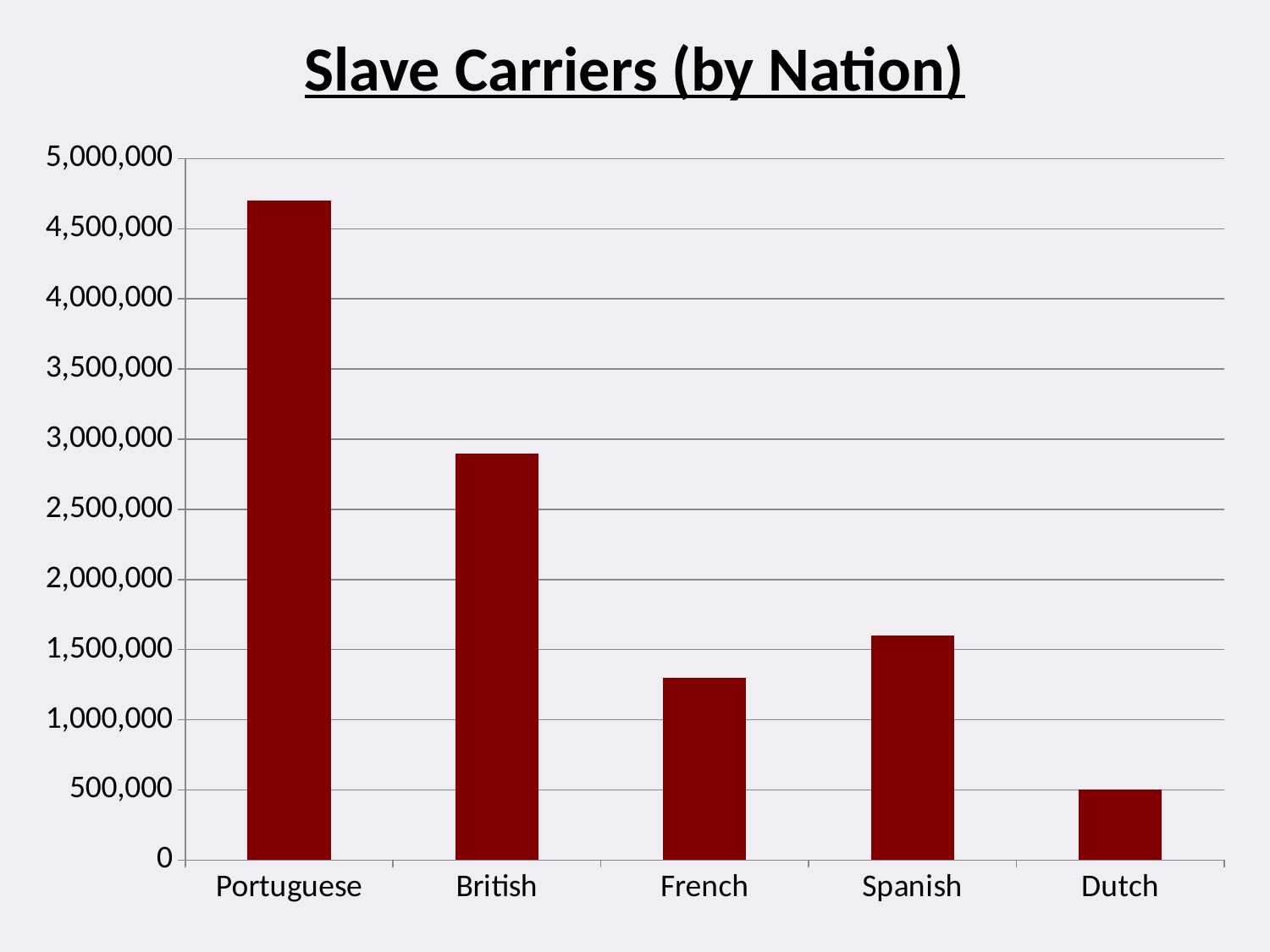
Which nation has the lowest bar in the chart? Dutch Is the value for British greater or less than 3,000,000? less Is the value for Spanish greater or less than 2,000,000? less Which nation has the highest bar in the chart? Portuguese How many nations are shown on the x axis of the chart? 5 Is the value for Portuguese greater or less than 4,500,000? greater What type of chart is shown on the slide? bar chart What is the title of the chart? Slave Carriers (by Nation) Which is larger, the value for British or the value for Portuguese? Portuguese Which is larger, the value for Spanish or the value for French? Spanish What is the value for Dutch in the chart? 500,000